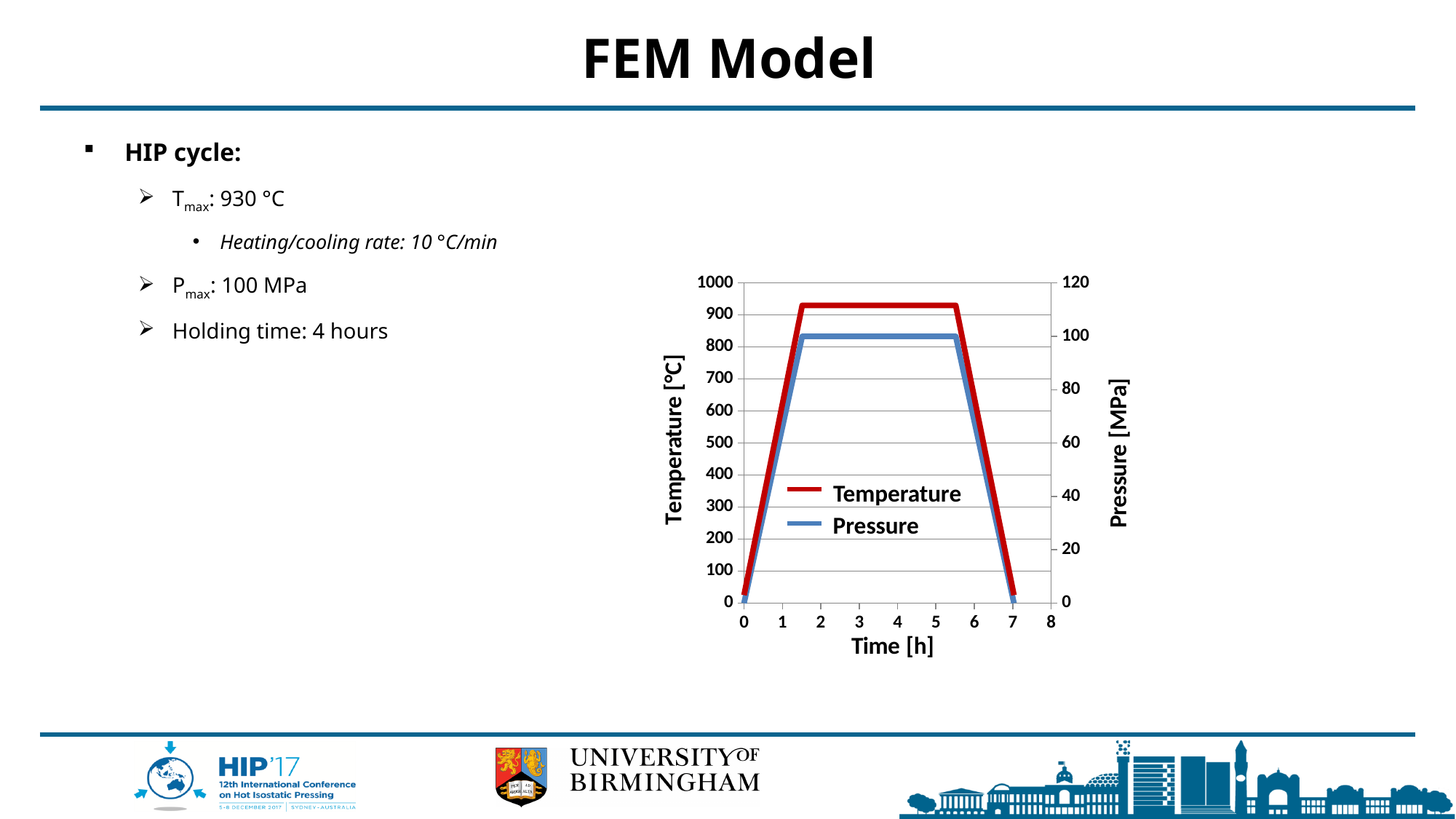
What pressure value, in MPa, does the Pressure line hold during its plateau? 100 Is the Temperature value at 7 h greater or less than 100 °C? less What are the two series named in the chart's legend? Temperature and Pressure Is the Pressure value at 6 h greater or less than 40 MPa? greater Between 6 h and 7 h, does the Pressure line rise or fall? fall Is the plateau value of the Temperature line greater or less than 900 °C? greater What kind of chart is shown on the slide? line chart Between 0 h and 1 h, does the Temperature line rise or fall? rise How many series does the chart's legend list? 2 What colour is the Temperature line in the chart? red